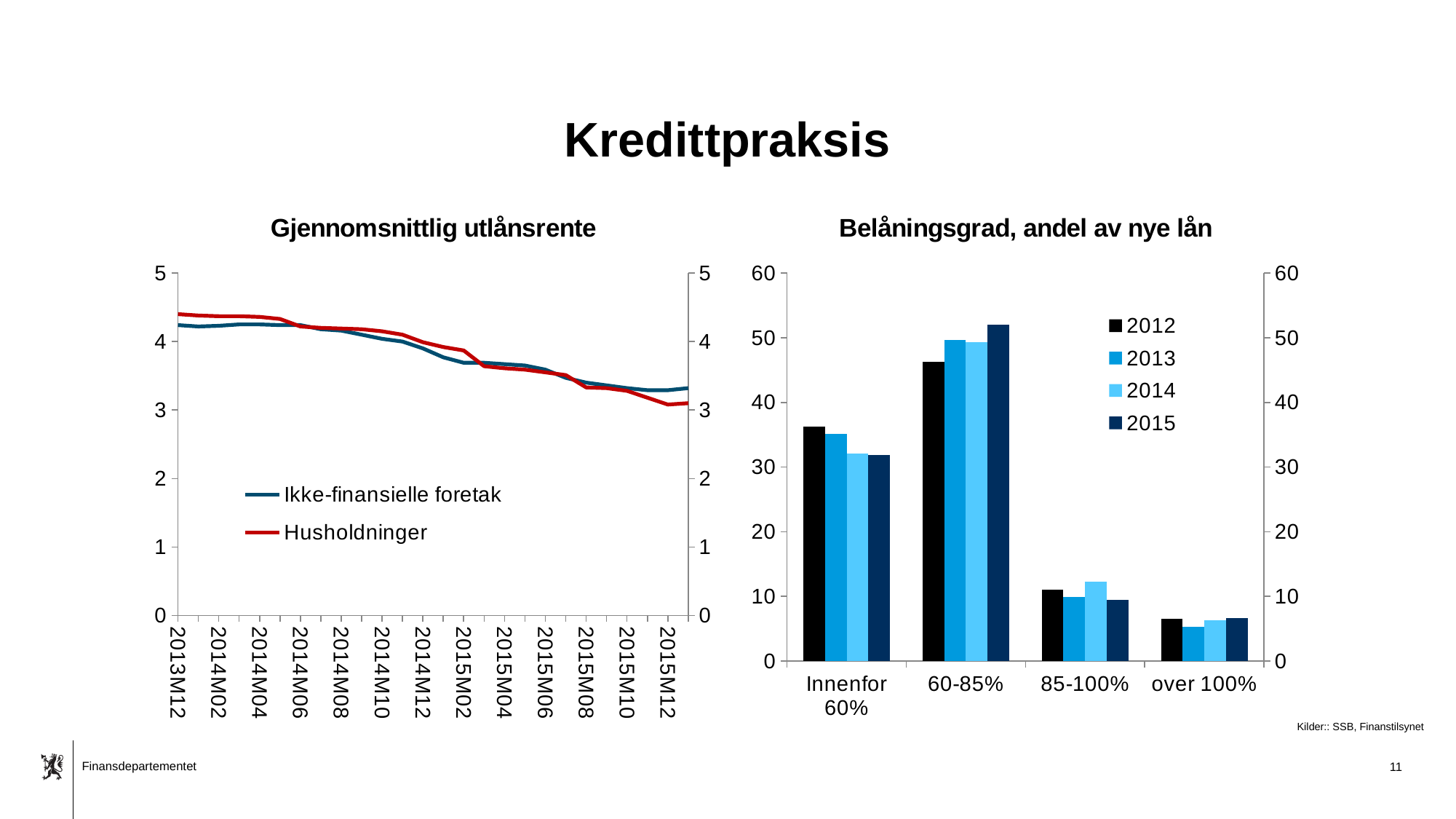
In the right chart 'Belåningsgrad, andel av nye lån', is the 2015 value for 60-85% greater or less than 50? greater In the left chart 'Gjennomsnittlig utlånsrente', is the value for Husholdninger at 2013M12 greater or less than 4? greater In the right chart 'Belåningsgrad, andel av nye lån', which is larger for Innenfor 60%: the 2012 value or the 2015 value? 2012 How many series does the legend of the left chart 'Gjennomsnittlig utlånsrente' list? 2 What kind of chart is the right chart, 'Belåningsgrad, andel av nye lån'? bar chart In the left chart 'Gjennomsnittlig utlånsrente', is the value for Ikke-finansielle foretak at 2015M12 greater or less than 4? less What kind of chart is the left chart, 'Gjennomsnittlig utlånsrente'? line chart How many categories are shown on the x axis of the right chart 'Belåningsgrad, andel av nye lån'? 4 In the left chart 'Gjennomsnittlig utlånsrente', do the values for Husholdninger rise or fall from 2013M12 to 2015M12? fall How many series does the legend of the right chart 'Belåningsgrad, andel av nye lån' list? 4 In the right chart 'Belåningsgrad, andel av nye lån', which category has the highest values? 60-85% In the right chart 'Belåningsgrad, andel av nye lån', which category has the lowest values? over 100%